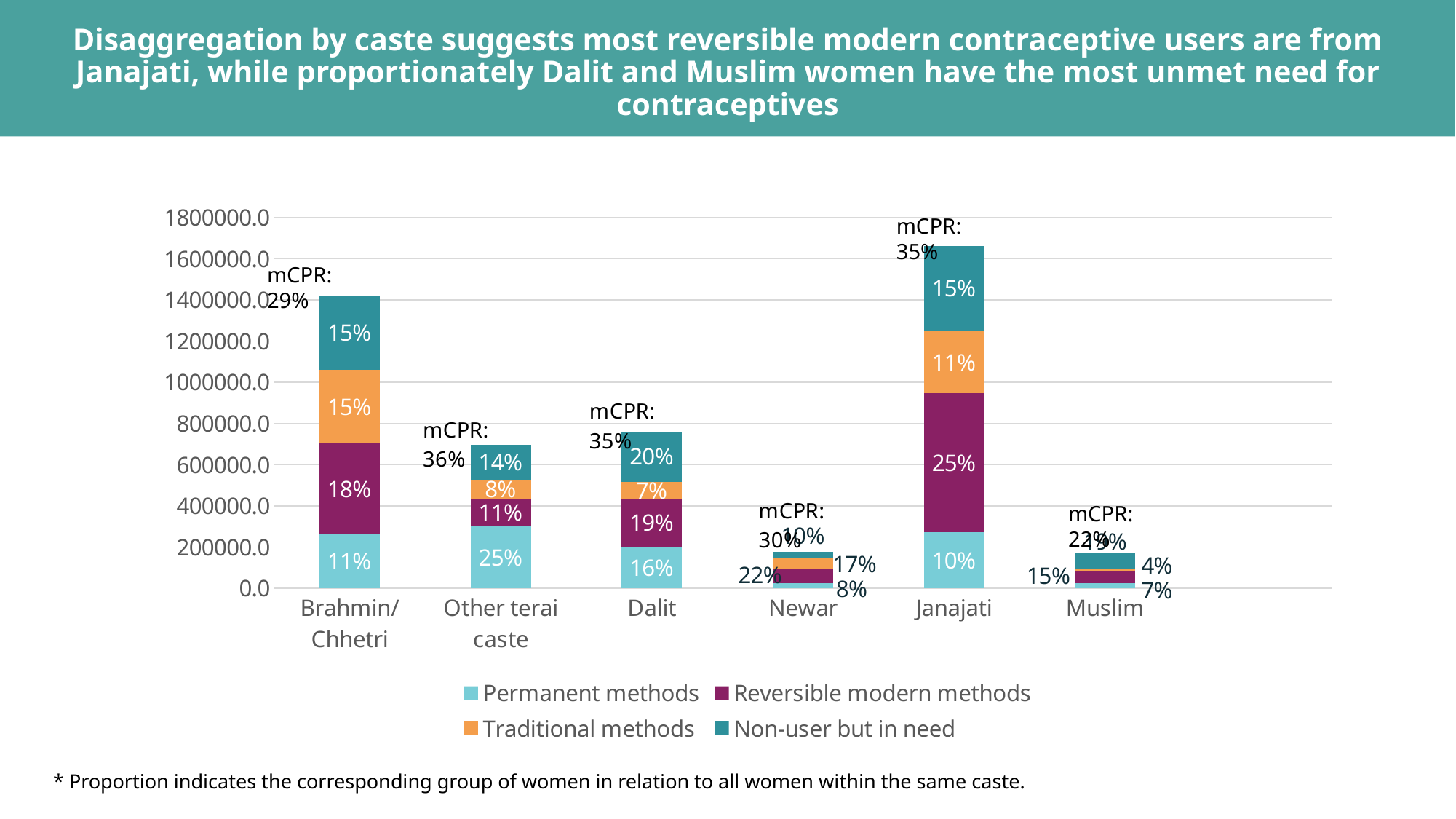
What mCPR value is shown above the Brahmin/Chhetri bar? 29% Is the total height of the Janajati bar greater or less than 1600000.0? greater What is the difference in percentage points between the Non-user but in need share for Dalit (20%) and for Brahmin/Chhetri (15%)? 5 percentage points How many series does the legend list? 4 What percentage label is shown for Reversible modern methods in the Janajati bar? 25% What percentage label is shown for Non-user but in need in the Dalit bar? 20% Which is larger: the Reversible modern methods share for Janajati or for Brahmin/Chhetri? Janajati Which caste has the tallest stacked bar overall? Janajati What kind of chart is shown on the slide? Stacked bar chart What percentage label is shown for Permanent methods in the Other terai caste bar? 25% How many caste categories are shown on the x axis? 6 Is the total height of the Dalit bar greater or less than 800000.0? less